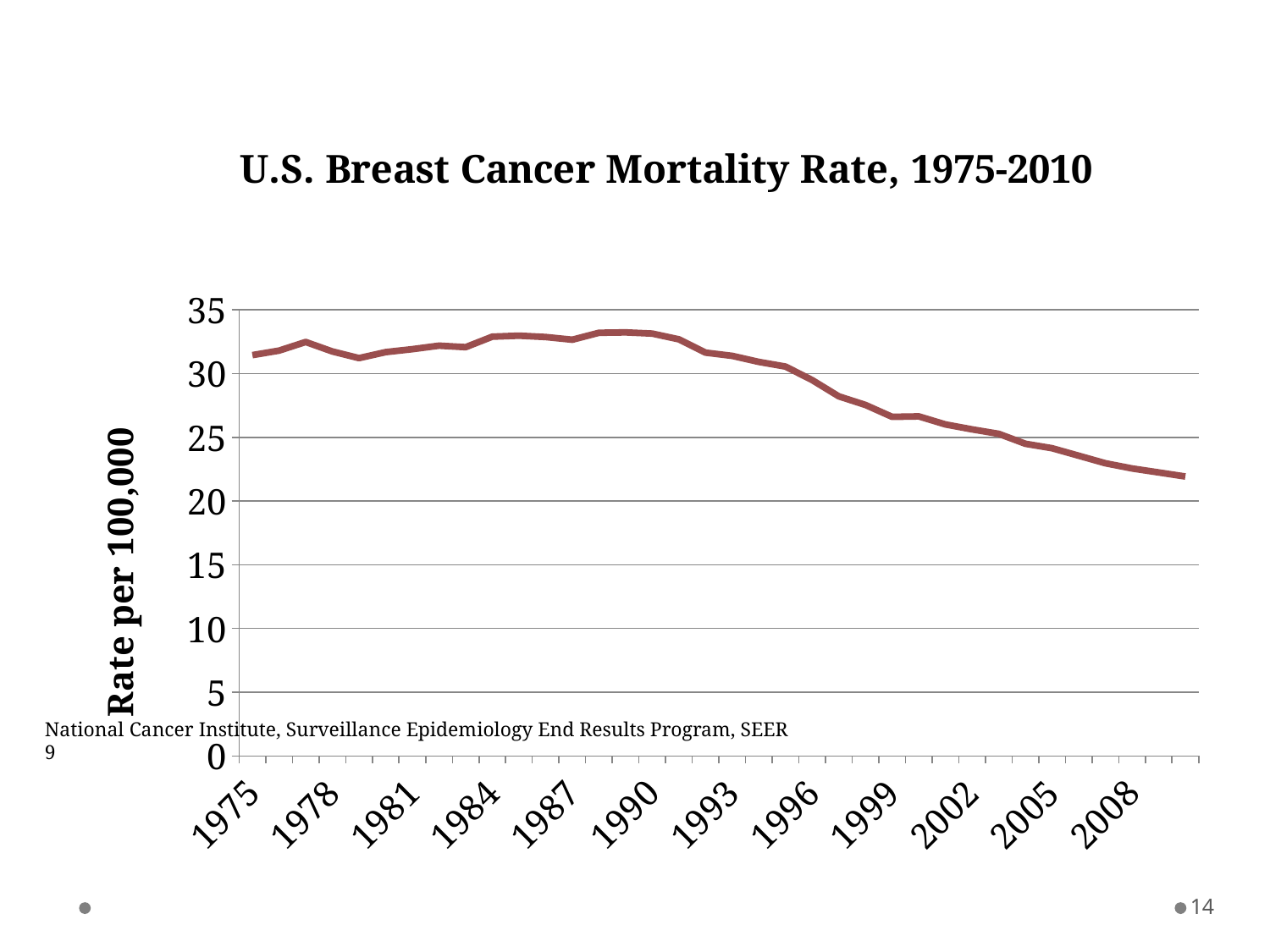
Is the value for 1990 greater or less than 30? greater Is the value for 1996 greater or less than 25? greater What is the label on the vertical axis of the chart? Rate per 100,000 Is the value for 2008 greater or less than 25? less What kind of chart is shown on the slide? line chart How many year labels are shown on the horizontal axis? 12 What is the title of the chart? U.S. Breast Cancer Mortality Rate, 1975-2010 Overall, does the mortality rate rise or fall from 1975 to 2010? fall Which year has the larger value, 1990 or 2008? 1990